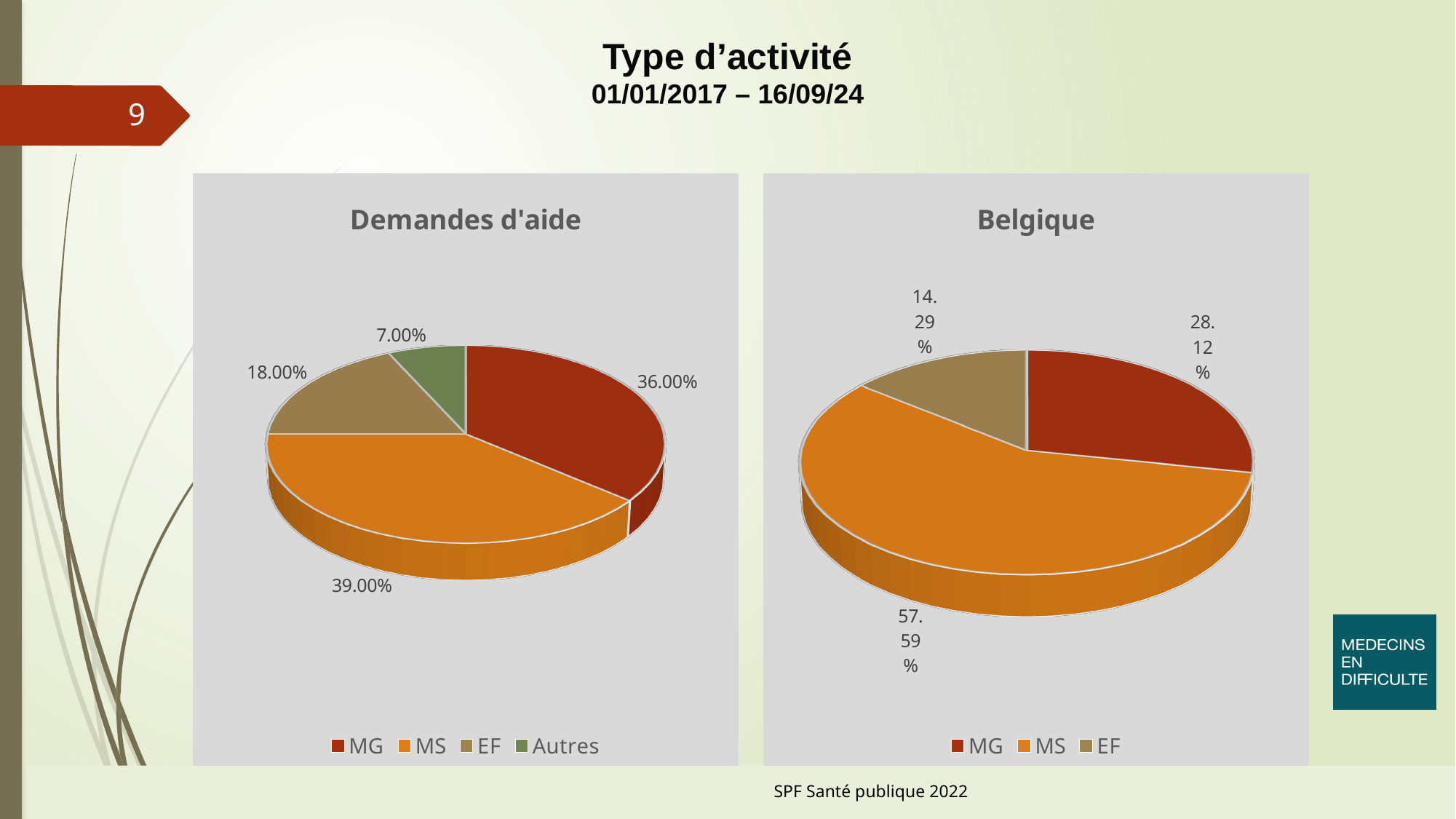
In the 'Demandes d'aide' chart, what is the difference between the MG share and the EF share? 18.00% In the 'Belgique' chart, what is the share for MS? 57.59% In the 'Belgique' chart, which category has the smallest slice? EF What type of chart is the 'Belgique' chart? Pie chart In the 'Demandes d'aide' chart, what is the share for Autres? 7.00% In the 'Belgique' chart, what is the difference between the MS share and the MG share? 29.47% Is the MG share larger in the 'Demandes d'aide' chart or in the 'Belgique' chart? Demandes d'aide In the 'Demandes d'aide' chart, which category has the largest slice? MS How many categories does the legend of the 'Demandes d'aide' chart list? 4 In the 'Demandes d'aide' chart, which category has the smallest slice? Autres In the 'Demandes d'aide' chart, what is the share for MS? 39.00% In the 'Belgique' chart, what is the share for EF? 14.29%